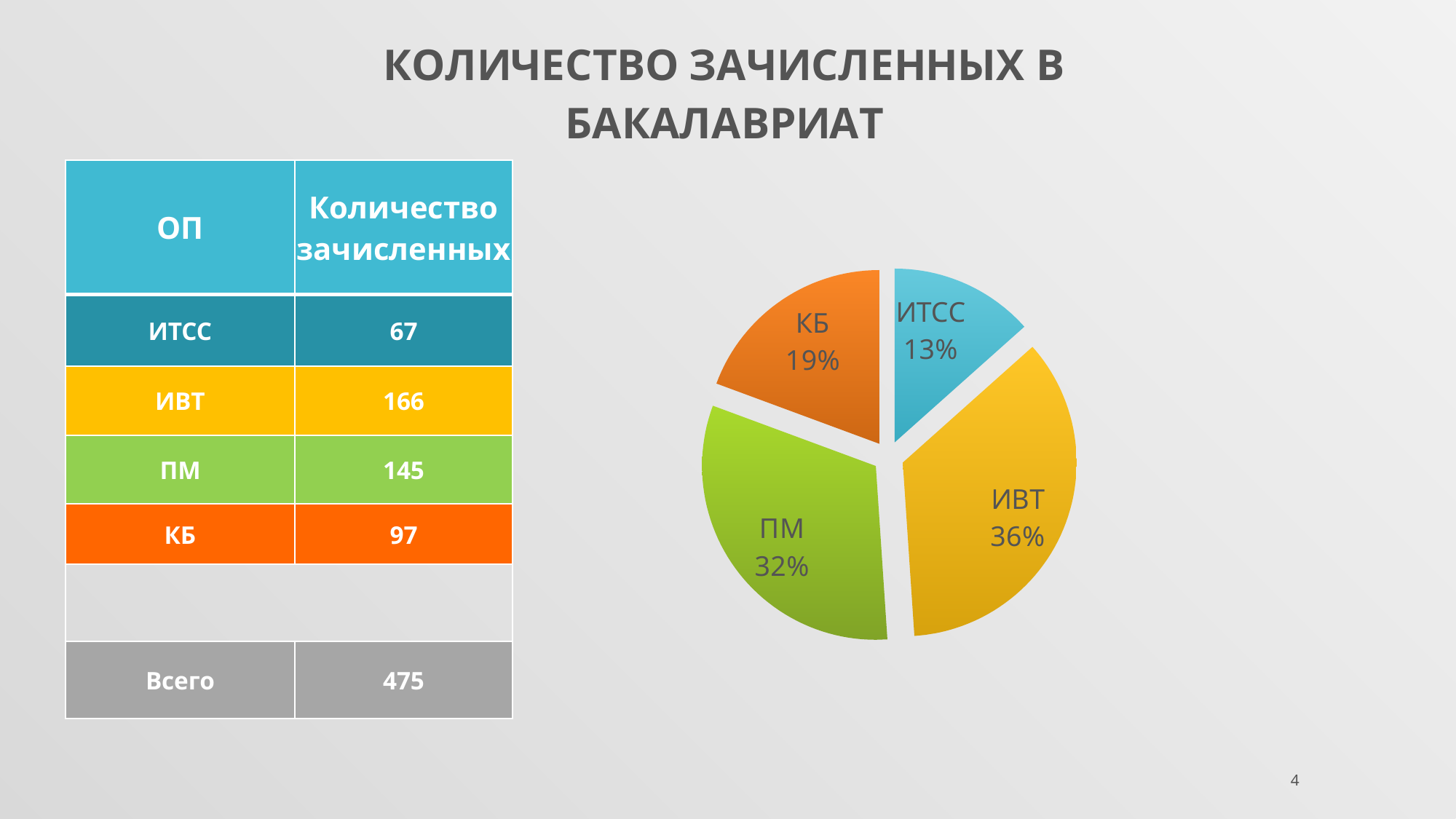
What share of the pie does КБ have? 19% What is the difference in percentage points between the ИВТ and ПМ slices? 4 What share of the pie does ИТСС have? 13% Which slice is larger, КБ or ИТСС? КБ What colour is the ПМ slice of the pie chart? green What share of the pie does ИВТ have? 36% Which slice of the pie chart is the largest? ИВТ What kind of chart is shown on the slide? pie chart What colour is the КБ slice of the pie chart? orange Which slice of the pie chart is the smallest? ИТСС How many slices does the pie chart have? 4